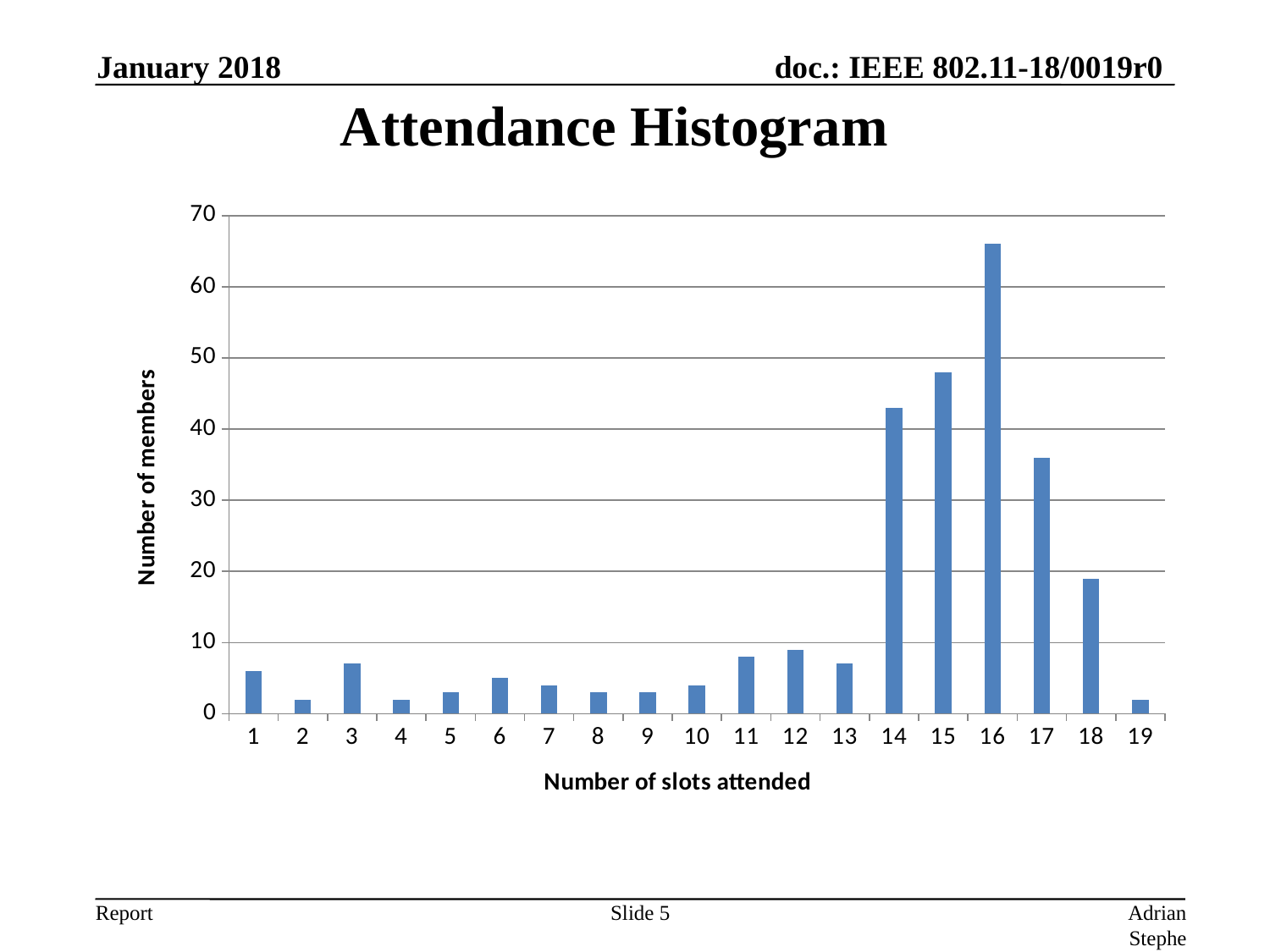
Is the number of members for 17 slots attended greater or less than 40? less Is the number of members for 15 slots attended greater or less than 50? less What kind of chart is shown on the slide? bar chart Is the number of members for 16 slots attended greater or less than 60? greater What is the title of the x axis? Number of slots attended Which has more members: 18 slots attended or 13 slots attended? 18 Which has more members: 14 slots attended or 17 slots attended? 14 How many categories (numbers of slots attended) are shown on the x axis? 19 Do the values rise or fall from 16 slots attended to 19 slots attended? fall Which number of slots attended has the highest number of members? 16